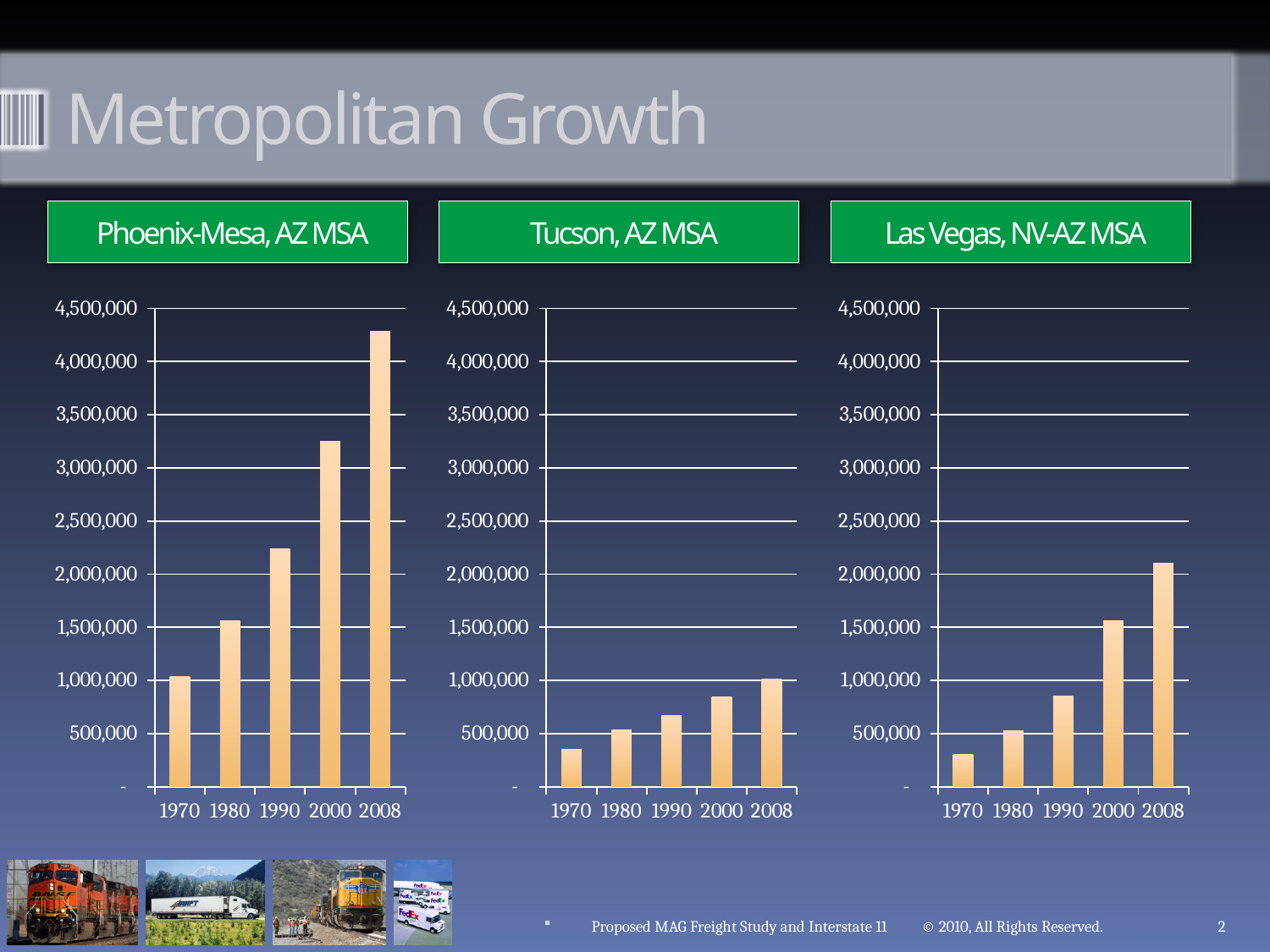
What kind of chart is used for the Phoenix-Mesa, AZ MSA data? bar chart In the Phoenix-Mesa, AZ MSA chart, is the value for 2008 greater or less than 4,000,000? greater How many years are plotted on the x axis of the Tucson, AZ MSA chart? 5 In the Tucson, AZ MSA chart, is the value for 2000 greater or less than 1,000,000? less In the Tucson, AZ MSA chart, which year has the lowest value? 1970 Which is larger: the 2008 value in the Phoenix-Mesa, AZ MSA chart or the 2008 value in the Las Vegas, NV-AZ MSA chart? Phoenix-Mesa, AZ MSA In the Las Vegas, NV-AZ MSA chart, is the value for 1970 greater or less than 500,000? less How many charts are shown on the slide? 3 In the Las Vegas, NV-AZ MSA chart, do the values rise or fall from 1970 to 2008? rise In the Phoenix-Mesa, AZ MSA chart, which year has the highest value? 2008